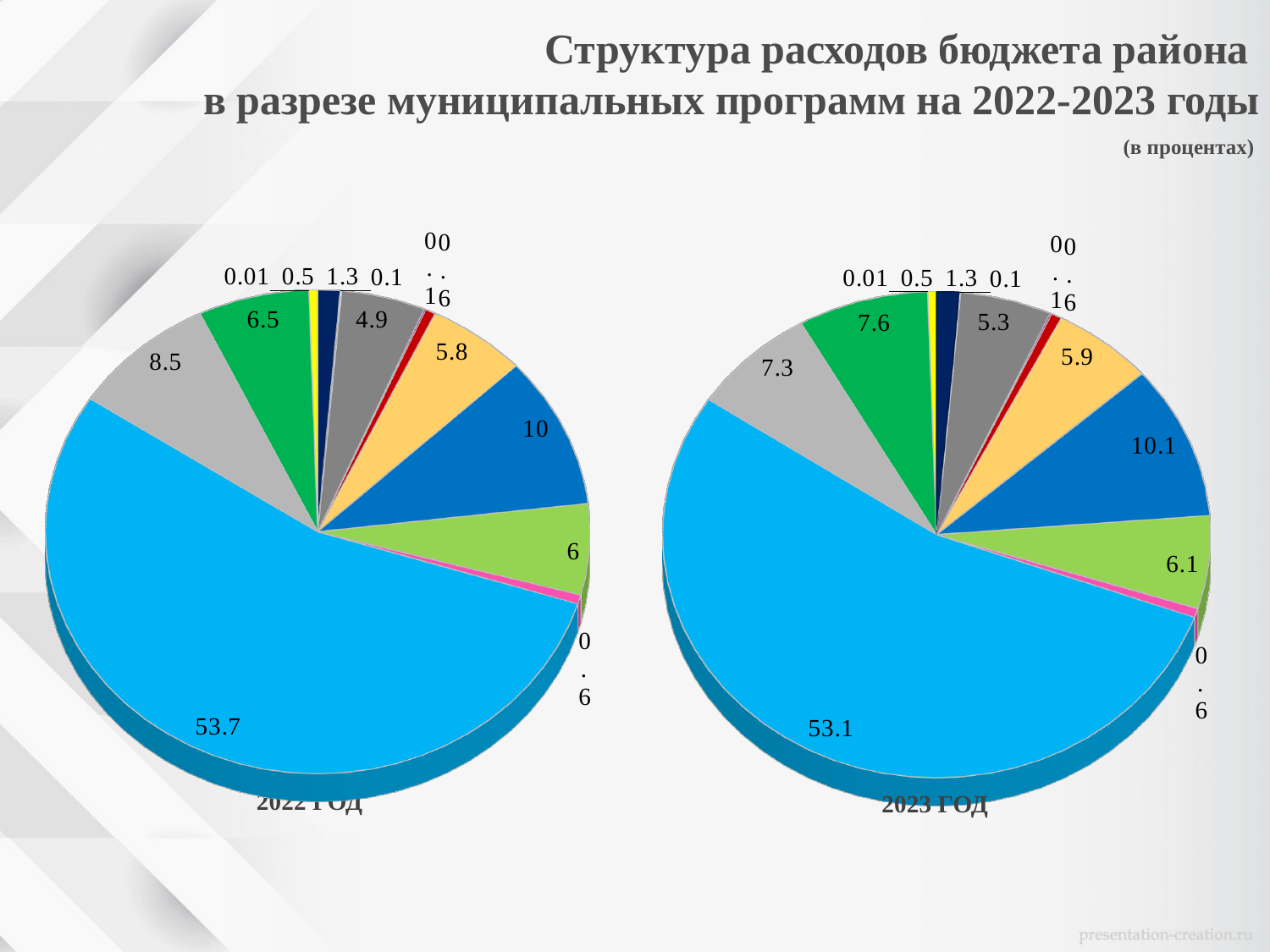
What is the difference between the largest slice in the 2022 ГОД pie chart (53.7) and the largest slice in the 2023 ГОД pie chart (53.1)? 0.6 In the 2022 ГОД pie chart, what is the value of the green slice? 6.5 In the 2023 ГОД pie chart, what is the value of the largest slice? 53.1 In what units are the values on the slide expressed, according to the subtitle? в процентах In the 2023 ГОД pie chart, what is the value of the green slice? 7.6 In the 2023 ГОД pie chart, what is the value of the dark blue slice? 10.1 In the 2022 ГОД pie chart, what is the value of the largest slice? 53.7 In the 2022 ГОД pie chart, what is the value of the light grey slice next to the largest slice? 8.5 Which is larger: the largest slice in the 2022 ГОД pie chart or the largest slice in the 2023 ГОД pie chart? 2022 ГОД In the 2023 ГОД pie chart, what is the value of the light green slice? 6.1 What kind of chart is used for the 2022 ГОД data? Pie chart In the 2022 ГОД pie chart, what is the value of the dark blue slice labelled next to the light green slice? 10